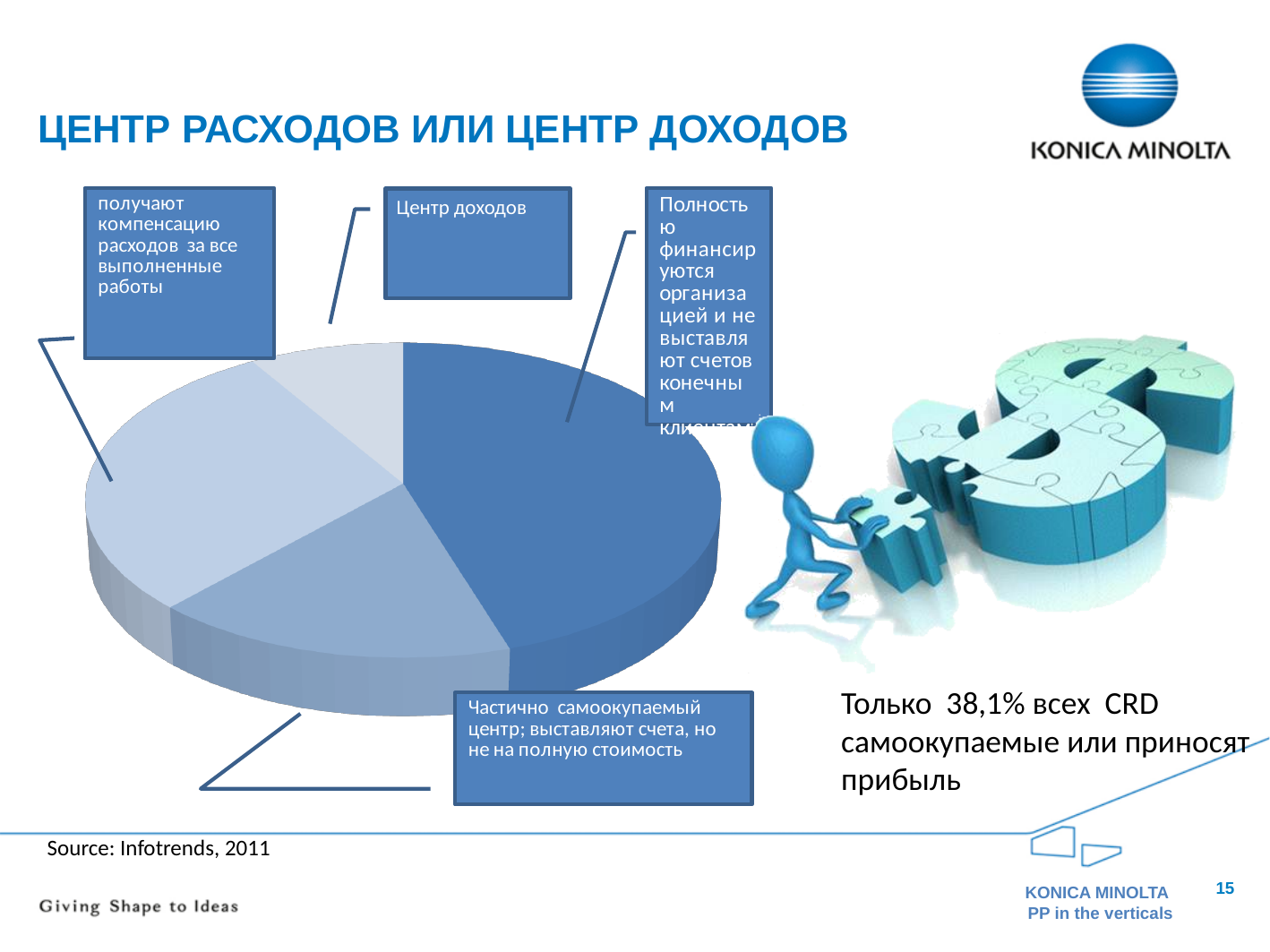
Which slice is larger: "Центр доходов" or "Частично самоокупаемый центр; выставляют счета, но не на полную стоимость"? Частично самоокупаемый центр; выставляют счета, но не на полную стоимость How many slices does the pie chart have? 4 What source is cited for the pie chart data? Infotrends, 2011 What is the title of the slide containing the pie chart? ЦЕНТР РАСХОДОВ ИЛИ ЦЕНТР ДОХОДОВ Which slice is larger: "Центр доходов" or "Полностью финансируются организацией и не выставляют счетов конечным клиентам"? Полностью финансируются организацией и не выставляют счетов конечным клиентам Which slice of the pie chart is the smallest? Центр доходов Which slice of the pie chart is the largest? Полностью финансируются организацией и не выставляют счетов конечным клиентам Which slice is larger: "Центр доходов" or "получают компенсацию расходов за все выполненные работы"? получают компенсацию расходов за все выполненные работы What kind of chart is shown on the slide? Pie chart